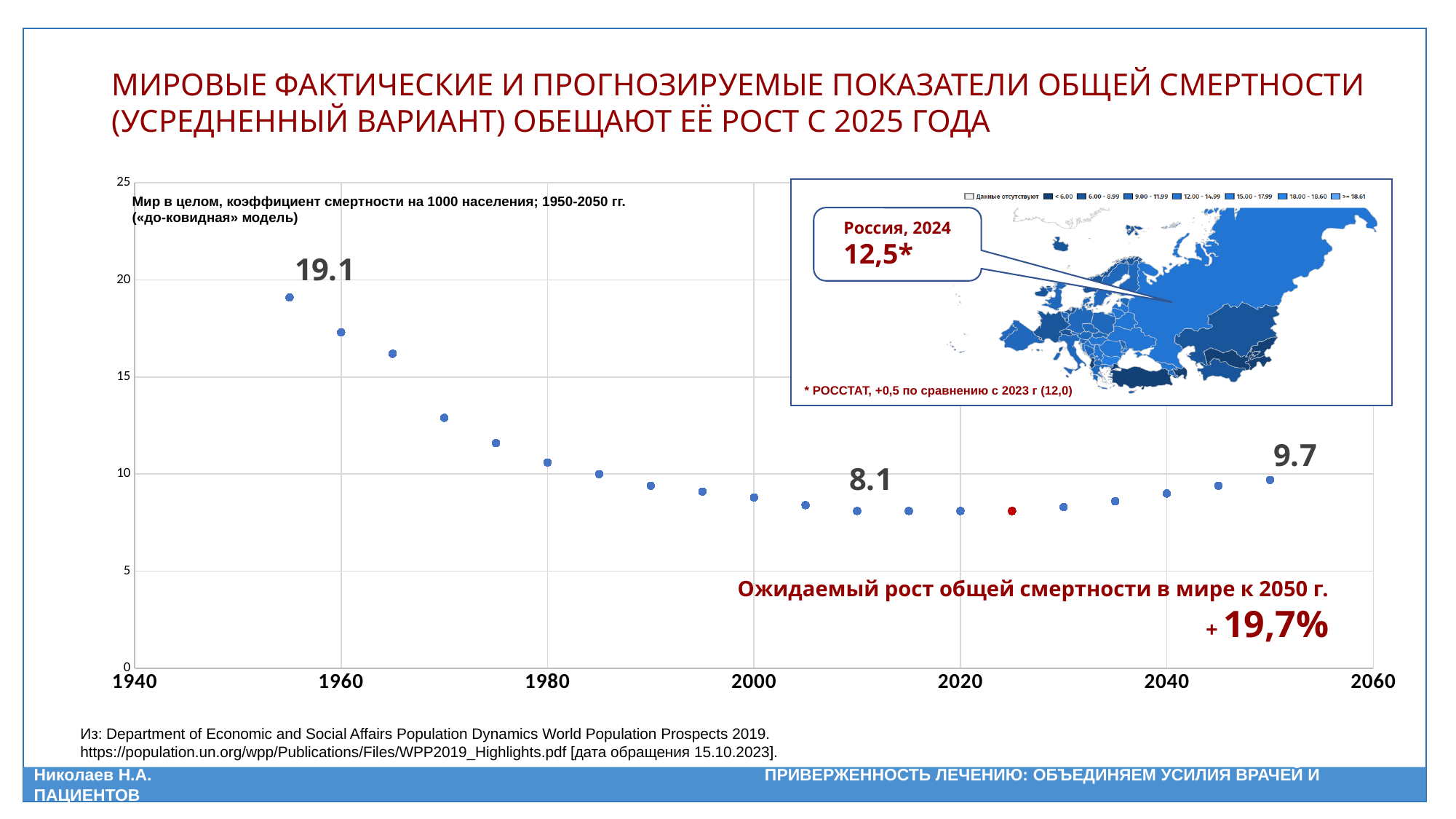
Is the value for 2000 greater or less than 10? less Do the values rise or fall between 1955 and 2010? fall What is the world mortality rate per 1000 population labelled for 1955? 19.1 What is the difference between the labelled 2050 value (9.7) and the labelled minimum (8.1)? 1.6 Is the value for 1980 greater or less than 10? greater What is the lowest value labelled on the chart? 8.1 In which year does the chart show its highest mortality rate? 1955 What is the projected world mortality rate per 1000 population labelled for 2050? 9.7 How many data points are plotted on the chart? 20 Which is larger, the value for 1955 or the value for 2050? 1955 What kind of chart is shown on the slide? scatter chart What is the difference between the labelled values for 1955 and 2050? 9.4